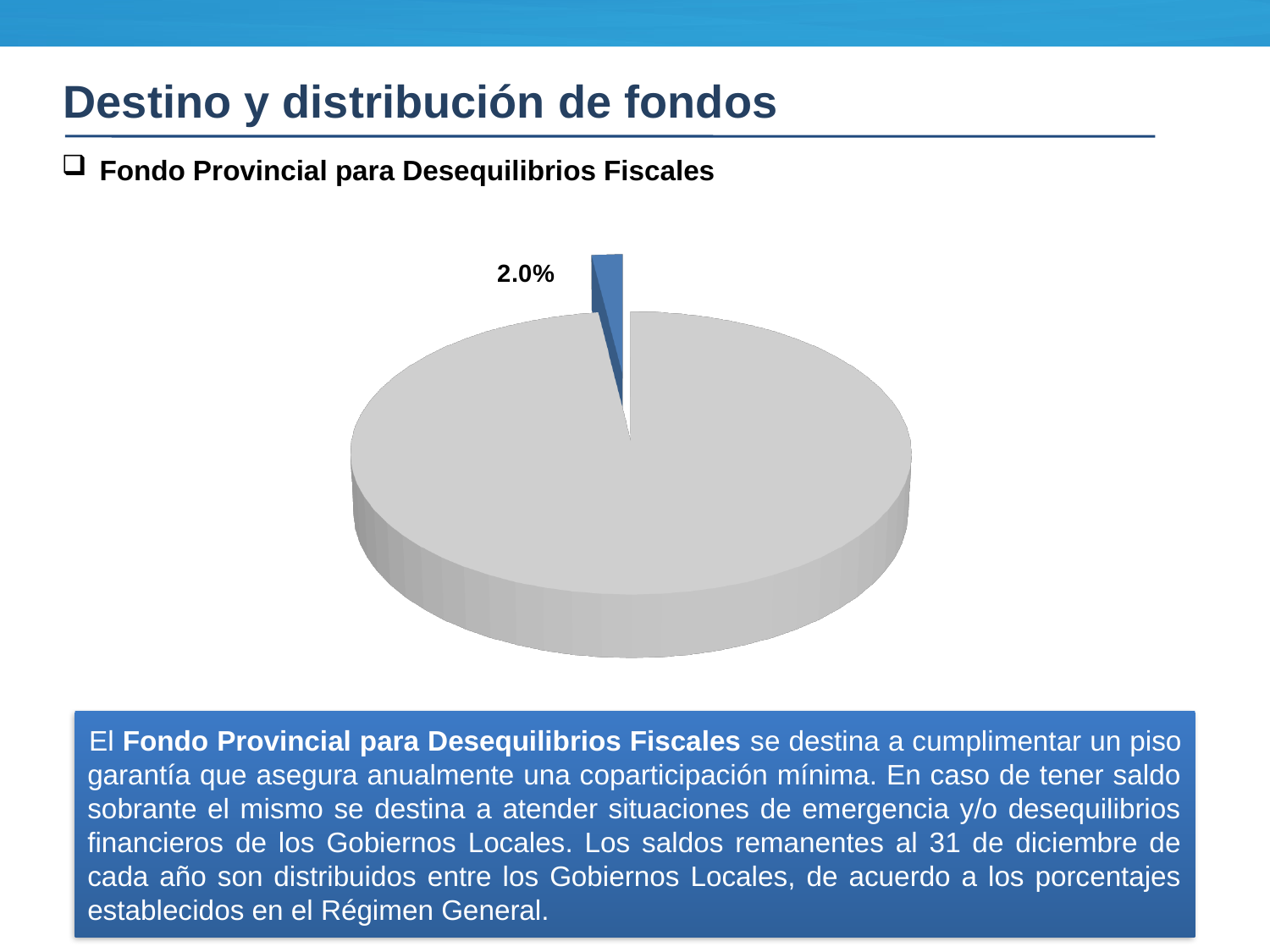
How many slices does the pie chart have? 2 What value is printed on the data label of the pie chart? 2.0% What share of the pie does the blue slice represent? 2.0% Which slice of the pie chart is larger, the blue slice or the gray slice? the gray slice Which slice of the pie chart is the smallest? the blue slice (2.0%) What kind of chart is shown on the slide? pie chart What colour is the slice labelled 2.0%? blue Is the share of the blue slice greater or less than 50%? less How many data labels are printed on the pie chart? 1